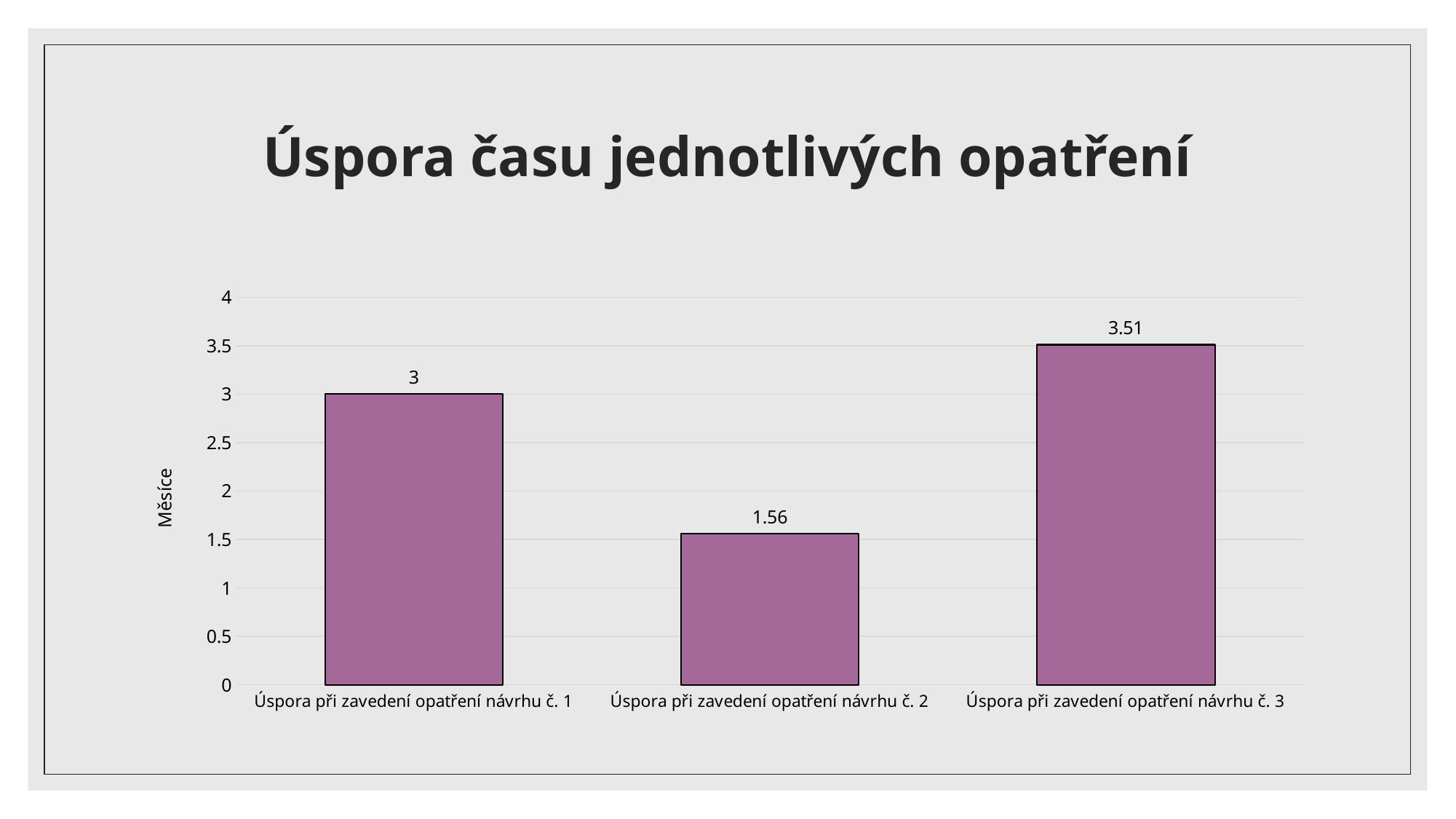
What is the value for 'Úspora při zavedení opatření návrhu č. 3'? 3.51 What kind of chart is shown on the slide? bar chart How many categories are shown in the chart? 3 Is the value for 'Úspora při zavedení opatření návrhu č. 2' greater or less than 2? less What is the difference between the values for návrhu č. 1 and návrhu č. 2? 1.44 Which category has the highest value? Úspora při zavedení opatření návrhu č. 3 What is the difference between the values for návrhu č. 3 and návrhu č. 1? 0.51 What is the label of the vertical axis? Měsíce What is the value for 'Úspora při zavedení opatření návrhu č. 1'? 3 Which category has the lowest value? Úspora při zavedení opatření návrhu č. 2 What is the value for 'Úspora při zavedení opatření návrhu č. 2'? 1.56 Which is larger, the value for návrhu č. 1 or návrhu č. 2? Úspora při zavedení opatření návrhu č. 1